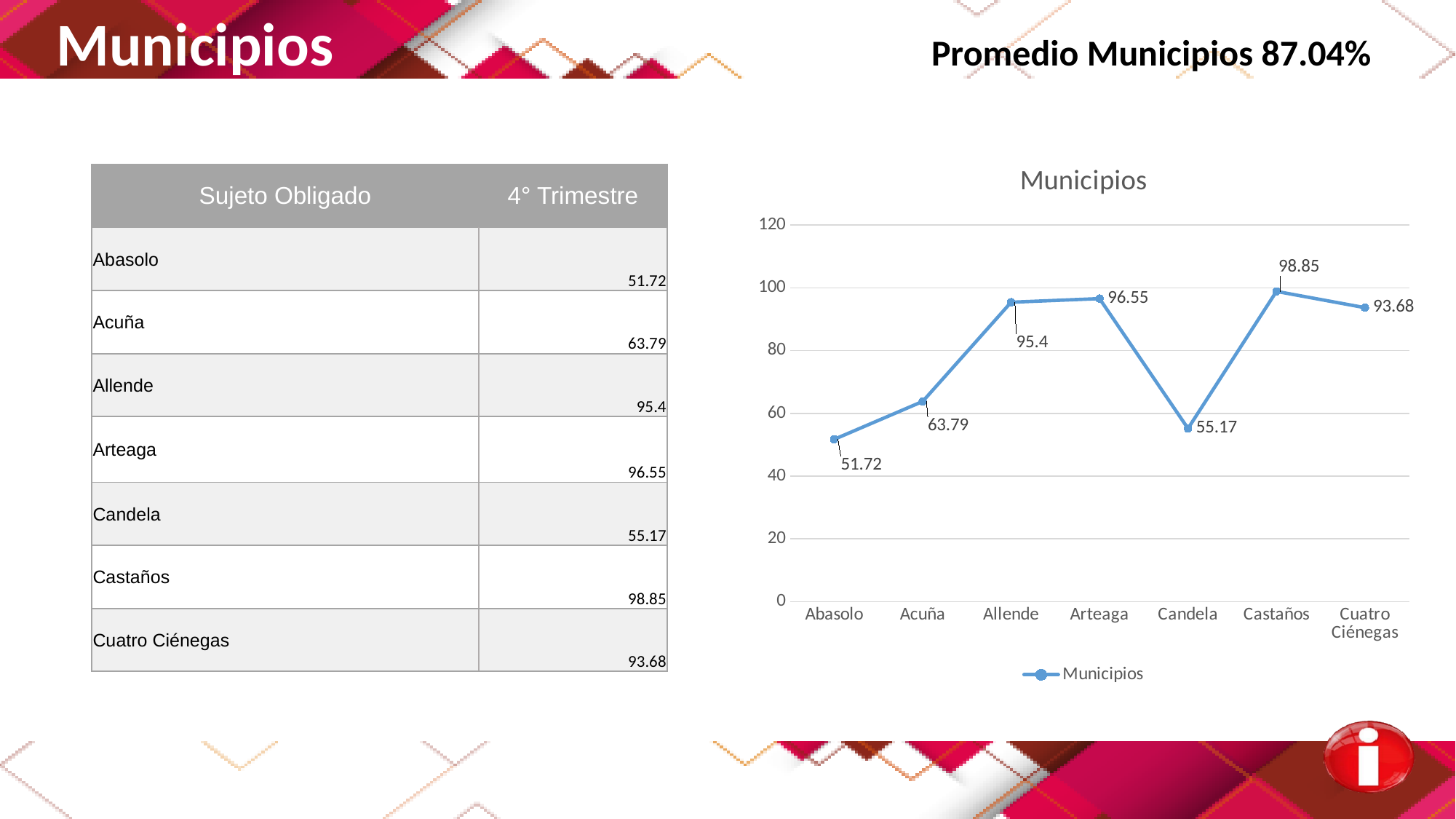
Which municipality has the highest value in the Municipios chart? Castaños How many series does the legend of the Municipios chart list? 1 What is the difference between the values for Castaños and Abasolo in the Municipios chart? 47.13 Which municipality has the lowest value in the Municipios chart? Abasolo Is the value for Arteaga in the Municipios chart greater or less than 80? greater How many municipalities are plotted in the Municipios chart? 7 Which has a larger value in the Municipios chart, Acuña or Candela? Acuña What is the value for Candela in the Municipios chart? 55.17 What is the value for Abasolo in the Municipios chart? 51.72 What kind of chart is the Municipios chart? line chart What is the title of the chart on the slide? Municipios What is the value for Cuatro Ciénegas in the Municipios chart? 93.68